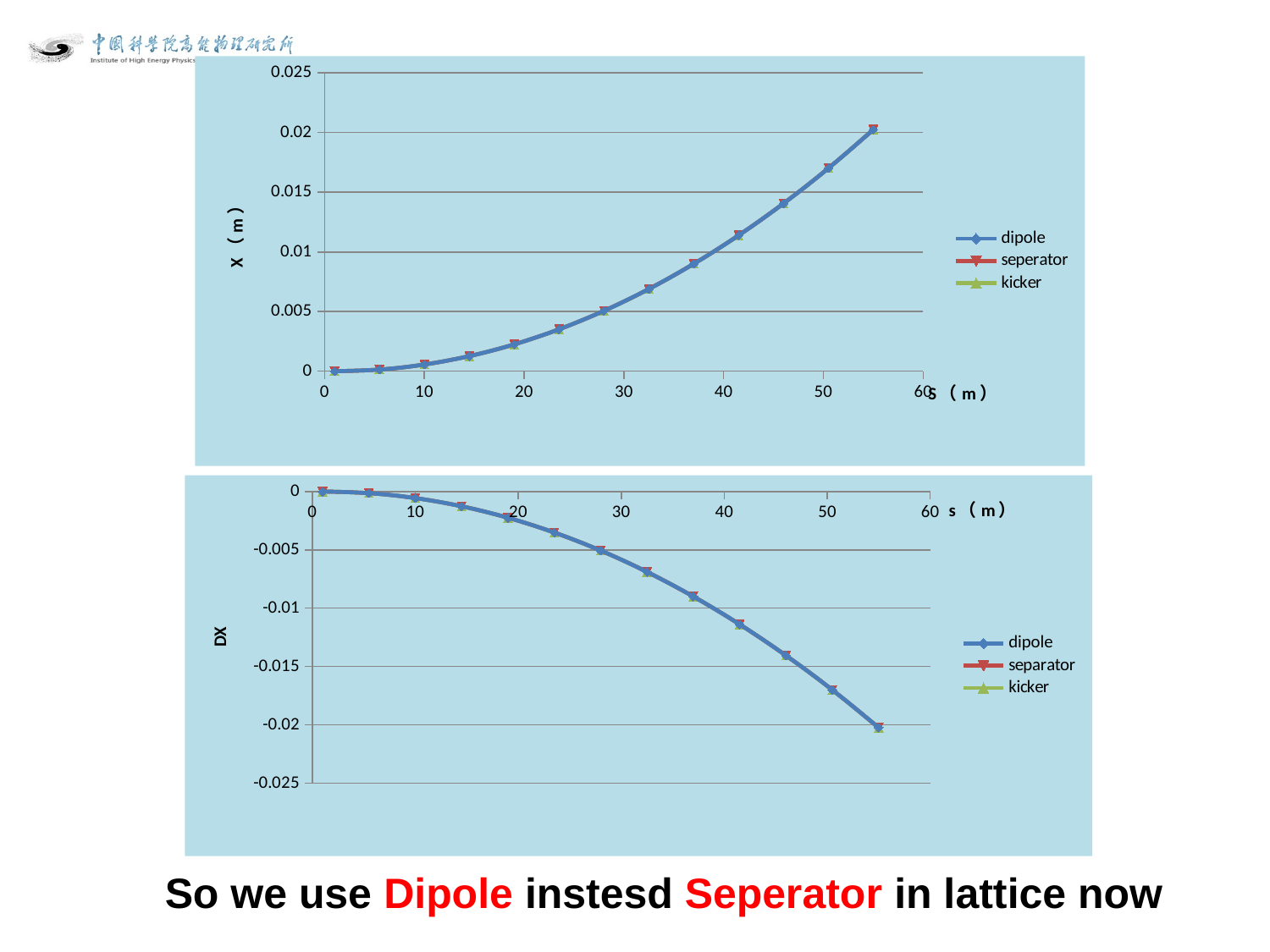
How many series does the legend of the top chart list? 3 In the bottom chart, do the values rise or fall as s increases along the x axis? fall In the top chart, which is larger: the dipole value at the point near s = 55 or the dipole value at the point near s = 10? the value near s = 55 In the top chart, is the value of the dipole series at its last point (near s = 55) greater or less than 0.015? greater What kind of chart is the top chart on the slide? line chart What is the label of the vertical axis of the top chart? X (m) How many series does the legend of the bottom chart list? 3 In the bottom chart, is the value of the dipole series at its last point (near s = 55) greater or less than -0.015? less In the bottom chart, is the value of the dipole series at the point near s = 28 greater or less than -0.01? greater In the top chart, do the values rise or fall as s increases along the x axis? rise What kind of chart is the bottom chart on the slide? line chart